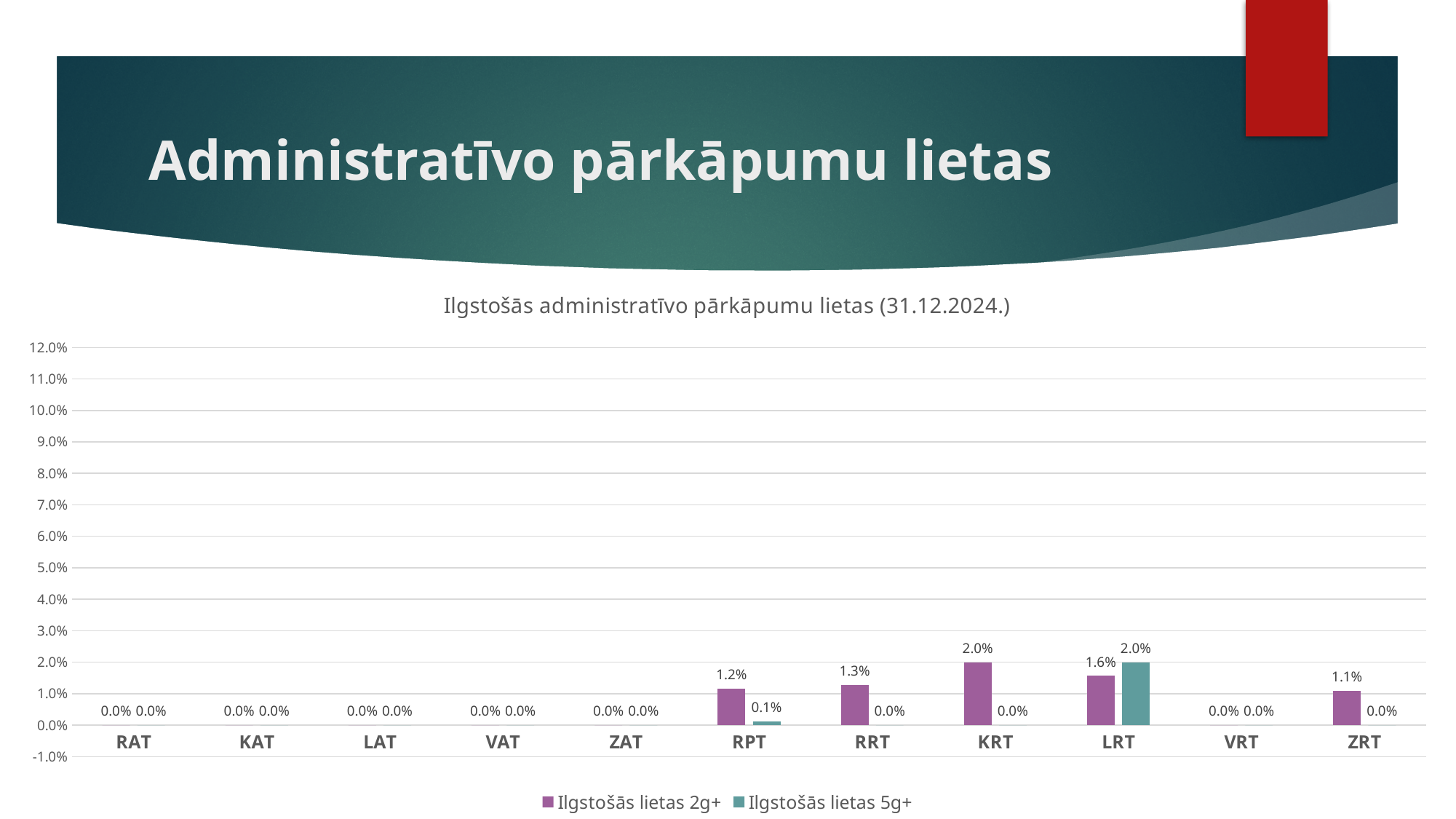
What is the value of Ilgstošās lietas 5g+ for RPT? 0.1% Which category has the highest value for Ilgstošās lietas 2g+? KRT Which category has the highest value for Ilgstošās lietas 5g+? LRT Is the Ilgstošās lietas 2g+ value for LRT greater or less than 1.0%? greater What is the value of Ilgstošās lietas 2g+ for ZRT? 1.1% How many series does the legend list? 2 What is the difference between the Ilgstošās lietas 2g+ values for KRT and RPT? 0.8% What is the difference between the Ilgstošās lietas 5g+ and Ilgstošās lietas 2g+ values for LRT? 0.4% How many categories are shown on the x axis? 11 What is the value of Ilgstošās lietas 2g+ for KRT? 2.0% Which is larger for Ilgstošās lietas 2g+: RRT or RPT? RRT What type of chart is shown on the slide? bar chart